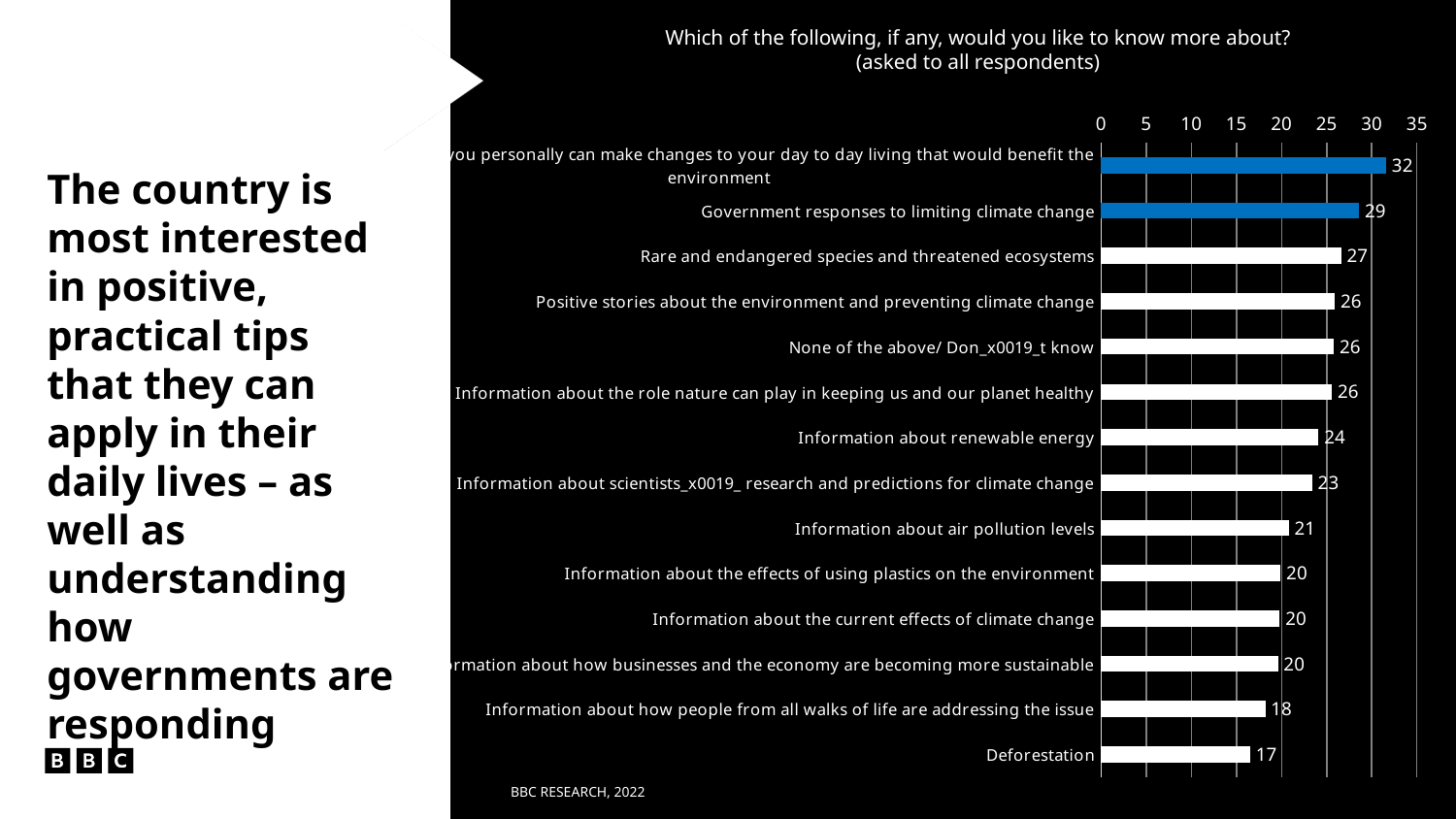
What is the title of the chart? Which of the following, if any, would you like to know more about? (asked to all respondents) What value is shown for Information about air pollution levels? 21 What kind of chart is shown on the slide? Bar chart What is the difference between the values for Government responses to limiting climate change and Deforestation? 12 What value is shown for Information about renewable energy? 24 What value is shown for Government responses to limiting climate change? 29 What is the difference between the values for Information about the effects of using plastics on the environment and Information about how people from all walks of life are addressing the issue? 2 What value is shown for Deforestation? 17 Which is larger: the value for Rare and endangered species and threatened ecosystems or the value for Information about renewable energy? Rare and endangered species and threatened ecosystems Which category has the lowest value? Deforestation How many categories are shown on the chart? 14 What is the highest value shown on the chart? 32